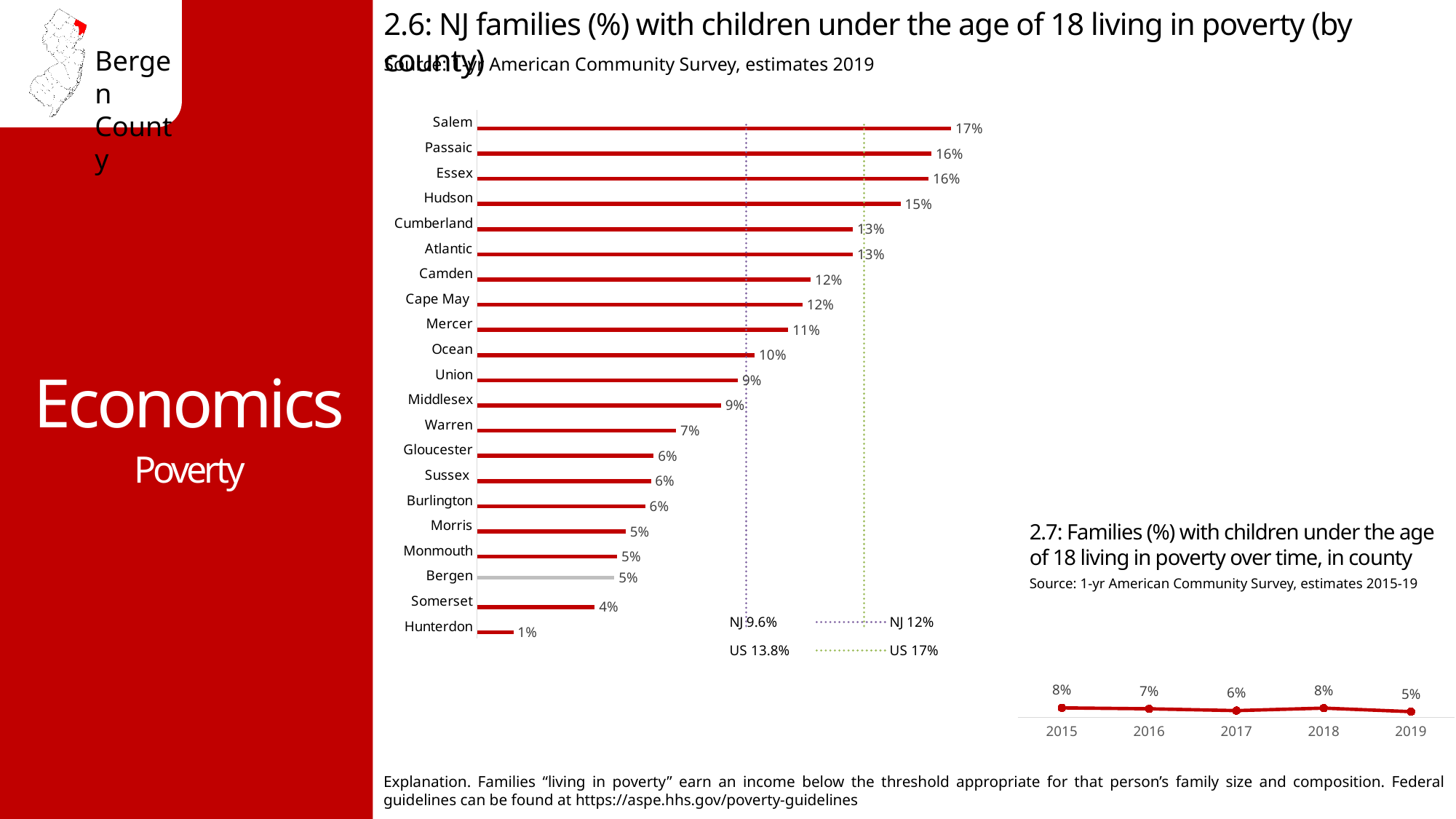
In chart 2.6, which county has the highest value? Salem In chart 2.7, what is the value for 2019? 5% In chart 2.6, which has a larger value, Hudson or Mercer? Hudson In chart 2.7, which year has the lowest value? 2019 In chart 2.6, what is the difference between the values for Salem and Hunterdon? 16% In chart 2.6, which county has the lowest value? Hunterdon In chart 2.6, what is the value for Bergen? 5% In chart 2.7, what is the difference between the values for 2015 and 2019? 3% What kind of chart is chart 2.6? Bar chart In chart 2.6, how many counties are plotted? 21 In chart 2.7, how many years are plotted? 5 In chart 2.6, what is the value for Salem? 17%